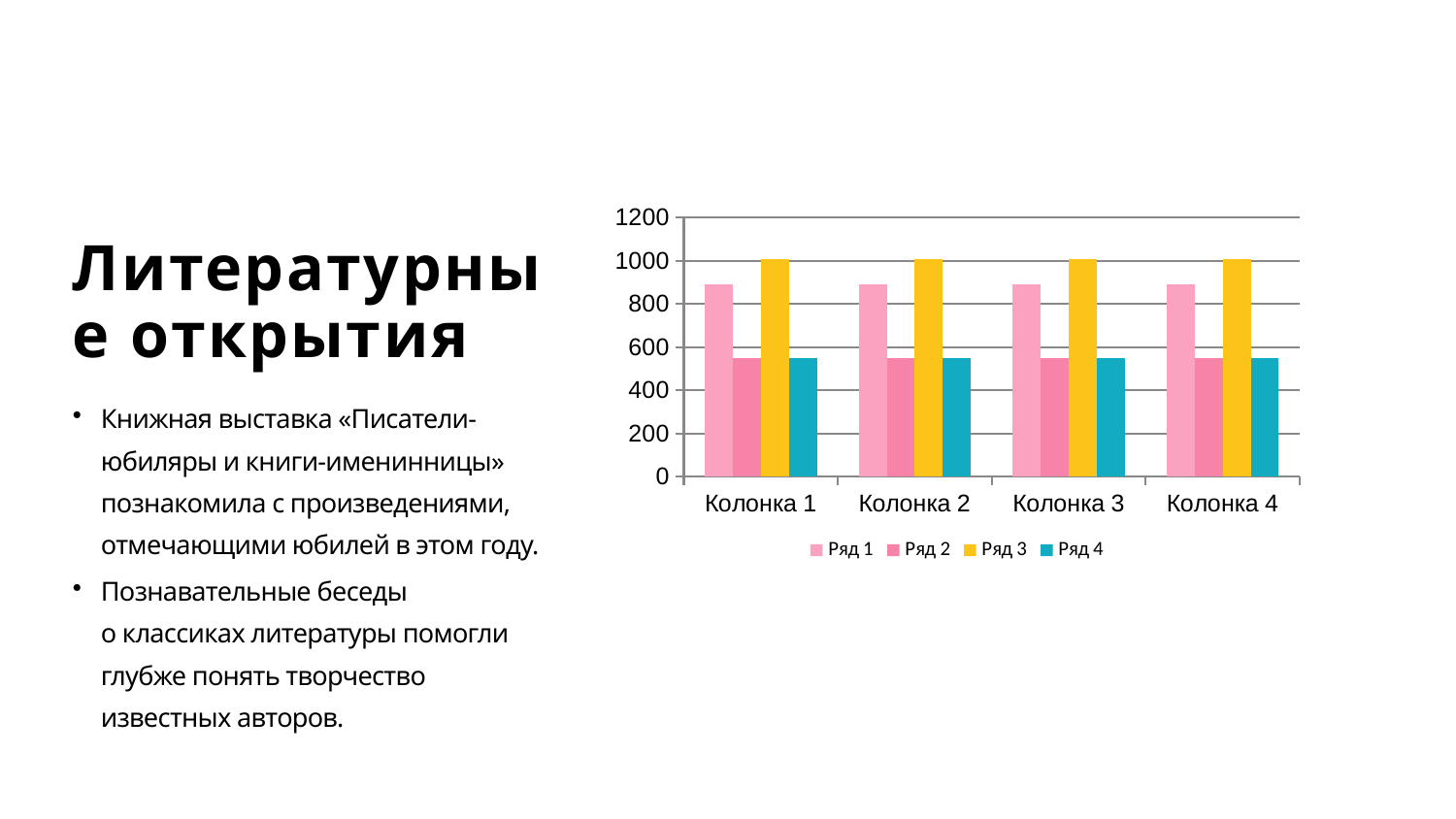
What kind of chart is shown on the slide? Bar chart Is the value for Ряд 2 in Колонка 2 greater or less than 600? less In Колонка 2, which is larger: Ряд 3 or Ряд 4? Ряд 3 Which series has the highest value in Колонка 1? Ряд 3 Is the value for Ряд 1 in Колонка 1 greater or less than 800? greater In Колонка 3, which is larger: Ряд 1 or Ряд 2? Ряд 1 How many categories are shown on the x axis of the chart? 4 Is the value for Ряд 3 in Колонка 3 greater or less than 800? greater How many series does the chart's legend list? 4 What are the entries listed in the chart's legend? Ряд 1, Ряд 2, Ряд 3, Ряд 4 Do the values for Ряд 1 rise, fall, or stay the same from Колонка 1 to Колонка 4? Stay the same